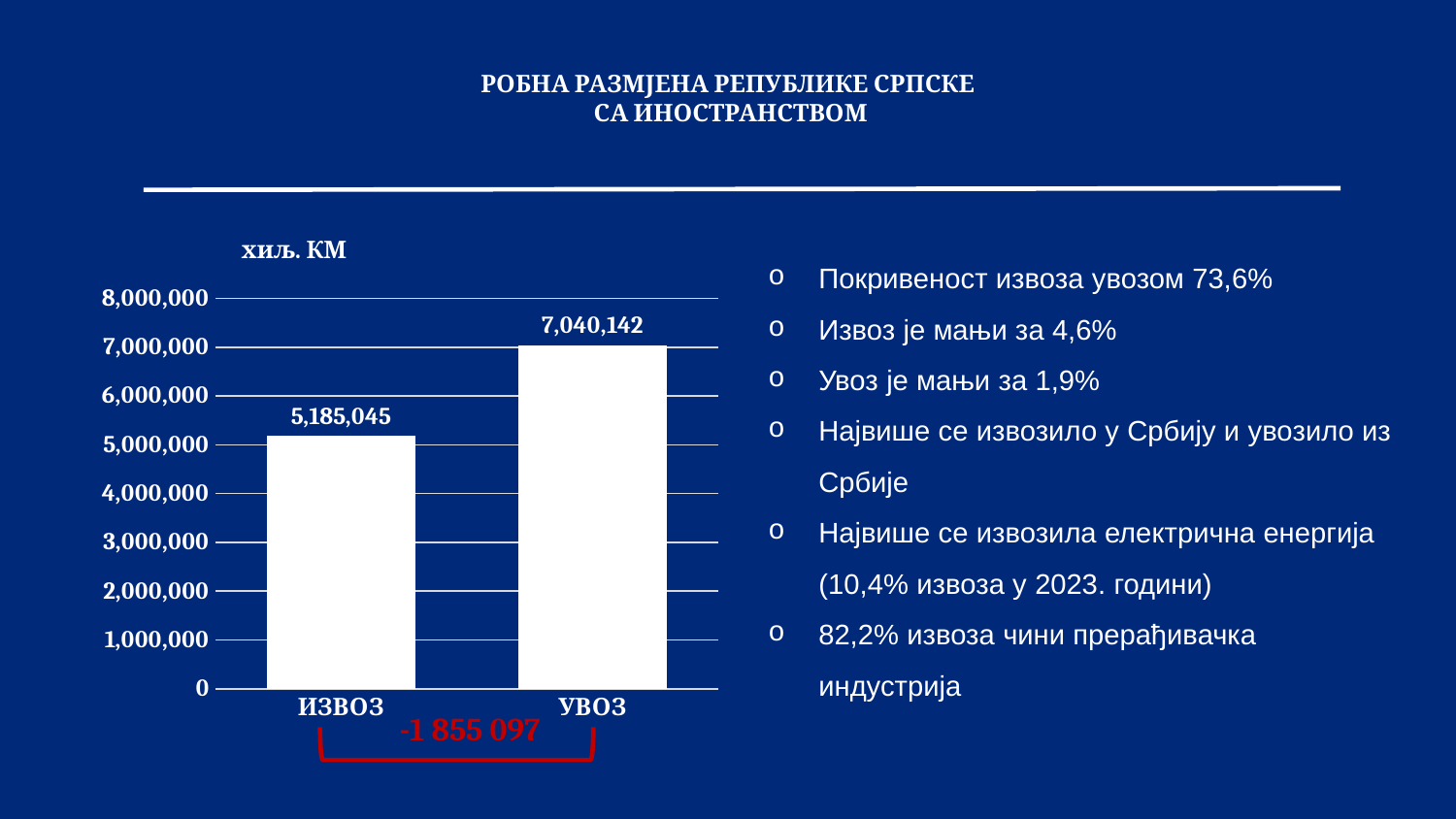
What is the highest tick value shown on the vertical axis? 8,000,000 Is the value for УВОЗ greater or less than 7,000,000? greater Which category has the lowest value? ИЗВОЗ Is the value for ИЗВОЗ greater or less than 6,000,000? less What is the difference between the values for УВОЗ and ИЗВОЗ? 1,855,097 What unit label is shown above the chart's vertical axis? хиљ. КМ Which category has the higher value, ИЗВОЗ or УВОЗ? УВОЗ What is the value for УВОЗ? 7,040,142 What is the value for ИЗВОЗ? 5,185,045 Which category has the highest value? УВОЗ What kind of chart is shown on the slide? bar chart How many categories are shown in the chart? 2